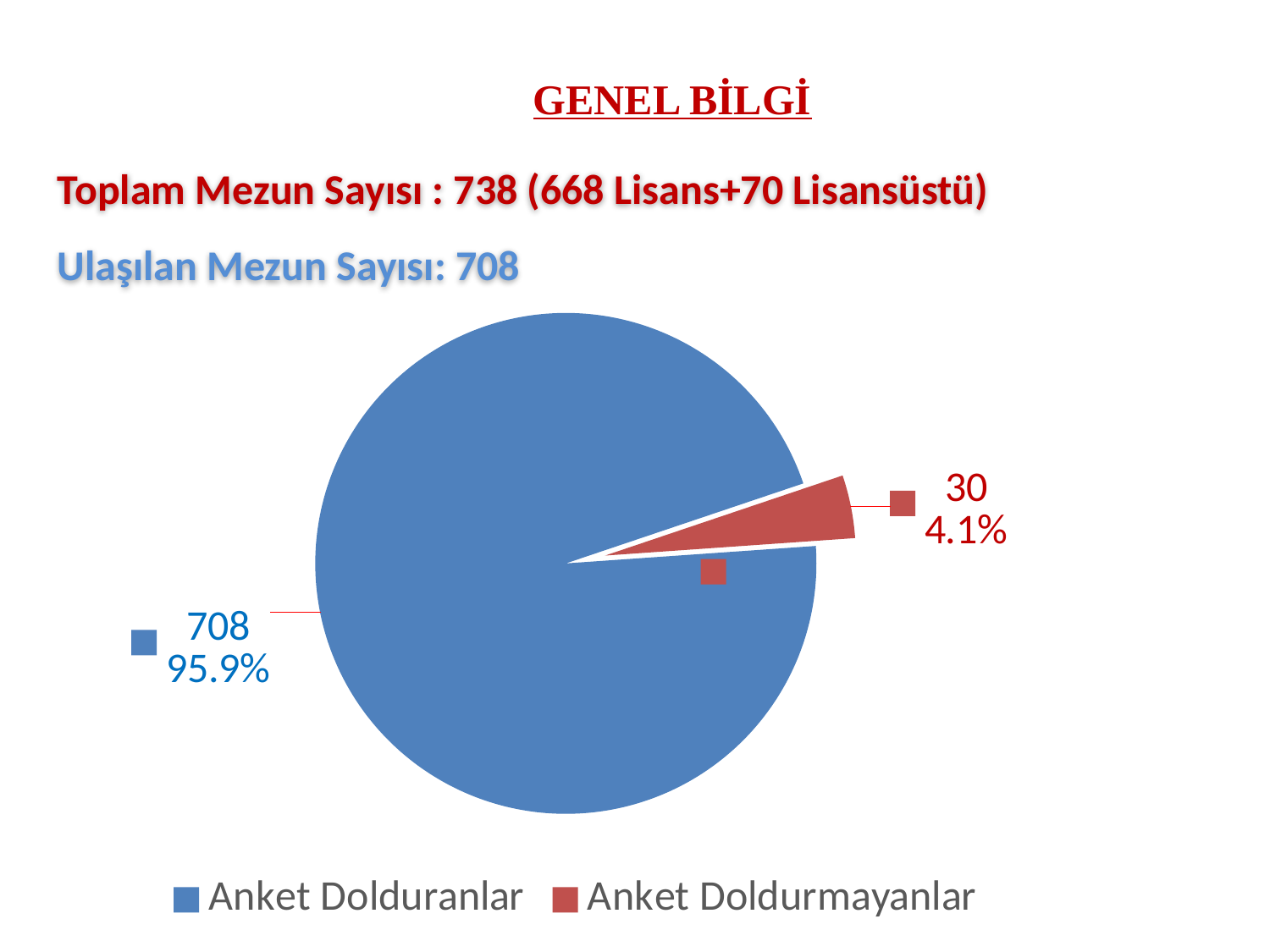
Which is larger, Anket Dolduranlar or Anket Doldurmayanlar? Anket Dolduranlar Which slice is the largest? Anket Dolduranlar What is the difference between the values for Anket Dolduranlar and Anket Doldurmayanlar? 678 How many slices does the pie chart have? 2 What colour is the Anket Doldurmayanlar slice? red What is the value for Anket Dolduranlar? 708 Which slice is the smallest? Anket Doldurmayanlar What share of the pie does Anket Dolduranlar represent? 95.9% How many entries does the legend list? 2 What share of the pie does Anket Doldurmayanlar represent? 4.1% What kind of chart is shown on the slide? pie chart What is the value for Anket Doldurmayanlar? 30